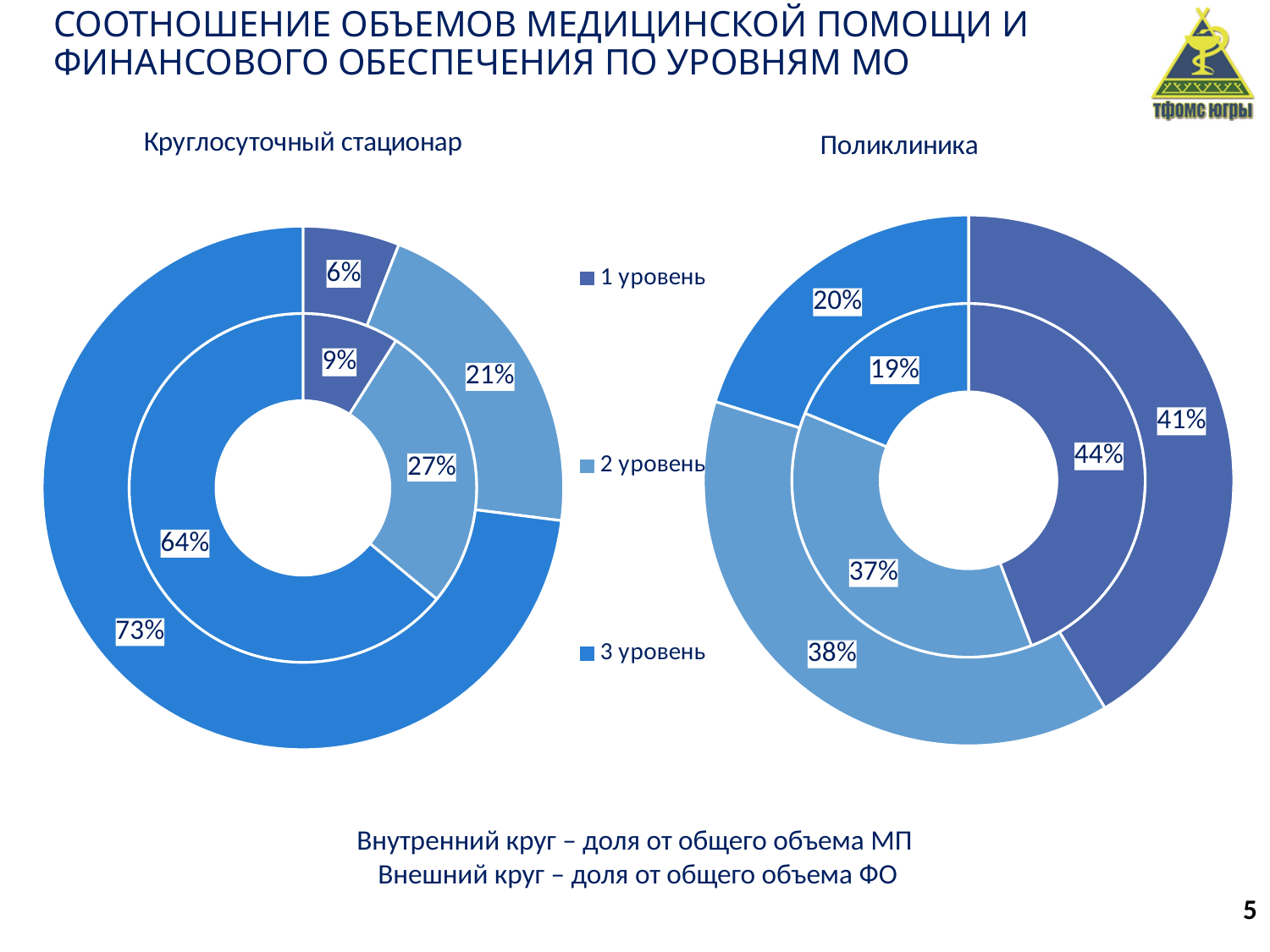
In the "Круглосуточный стационар" chart, what is the inner-ring value for 3 уровень? 64% In the "Поликлиника" chart, what is the outer-ring value for 3 уровень? 20% In the "Поликлиника" chart, which level has the largest share in the outer ring? 1 уровень In the "Круглосуточный стационар" chart, what is the difference between the outer-ring and inner-ring values for 3 уровень? 9 percentage points In the "Круглосуточный стационар" chart, which level has the smallest share in the inner ring? 1 уровень In the "Круглосуточный стационар" chart, what is the outer-ring value for 1 уровень? 6% How many series does the legend list? 3 In the "Поликлиника" chart, what is the inner-ring value for 1 уровень? 44% In the "Поликлиника" chart, which is larger: the inner-ring value for 2 уровень or the inner-ring value for 3 уровень? 2 уровень According to the note below the charts, what does the inner ring represent? Доля от общего объема МП What kind of chart is used for "Круглосуточный стационар"? Doughnut (pie) chart In the "Круглосуточный стационар" chart, what is the outer-ring value for 2 уровень? 21%